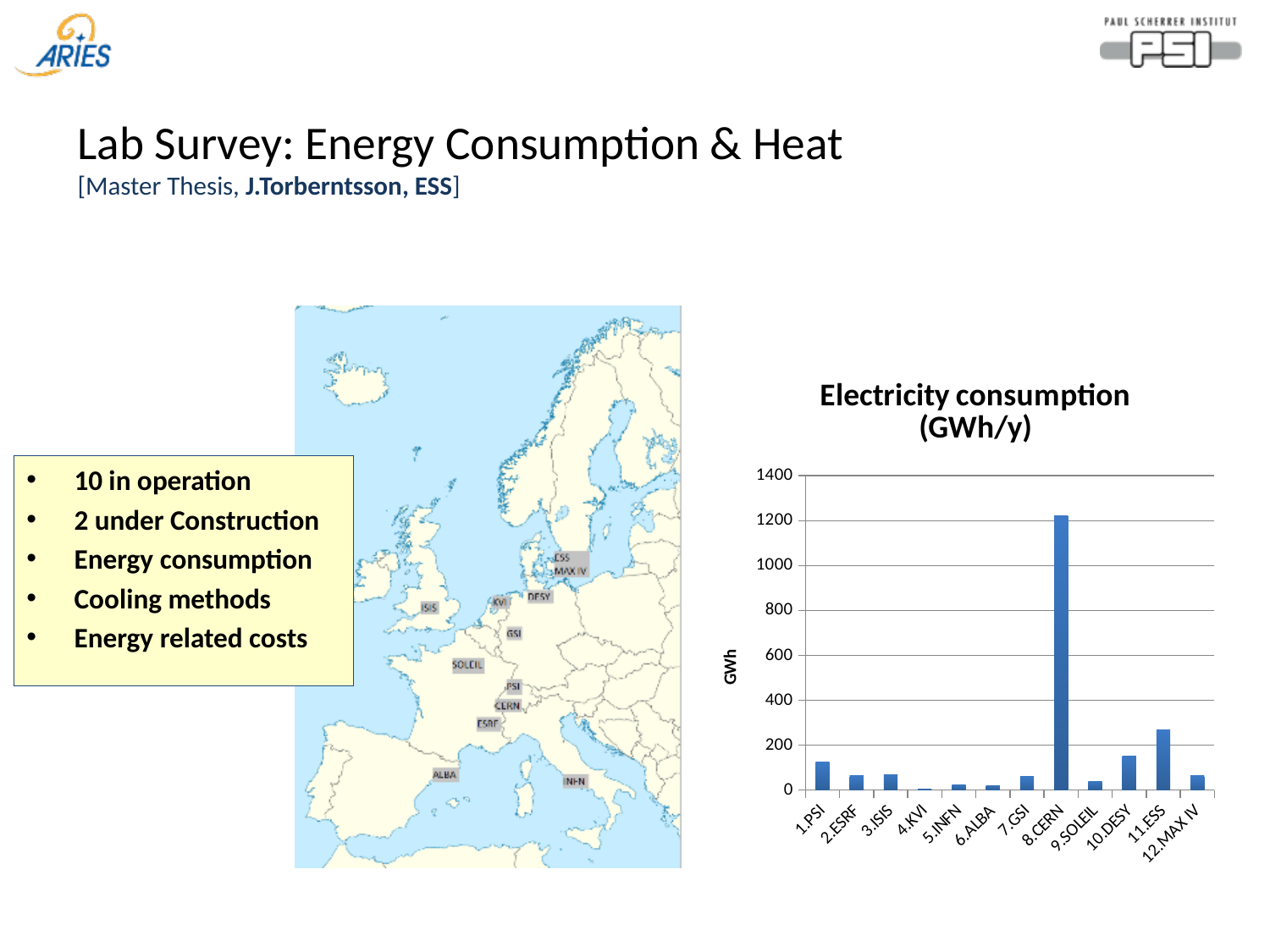
Is the electricity consumption value for 11.ESS greater or less than 200? greater Is the electricity consumption value for 11.ESS greater or less than 400? less Is the electricity consumption value for 10.DESY greater or less than 200? less Which laboratory has the highest electricity consumption in the chart? 8.CERN How many laboratories (categories) are plotted in the Electricity consumption chart? 12 Which has the larger electricity consumption, 1.PSI or 2.ESRF? 1.PSI What is the title of the chart on the slide? Electricity consumption (GWh/y) Which has the larger electricity consumption, 11.ESS or 10.DESY? 11.ESS What is the label on the vertical axis of the chart? GWh What kind of chart is shown on the slide? bar chart